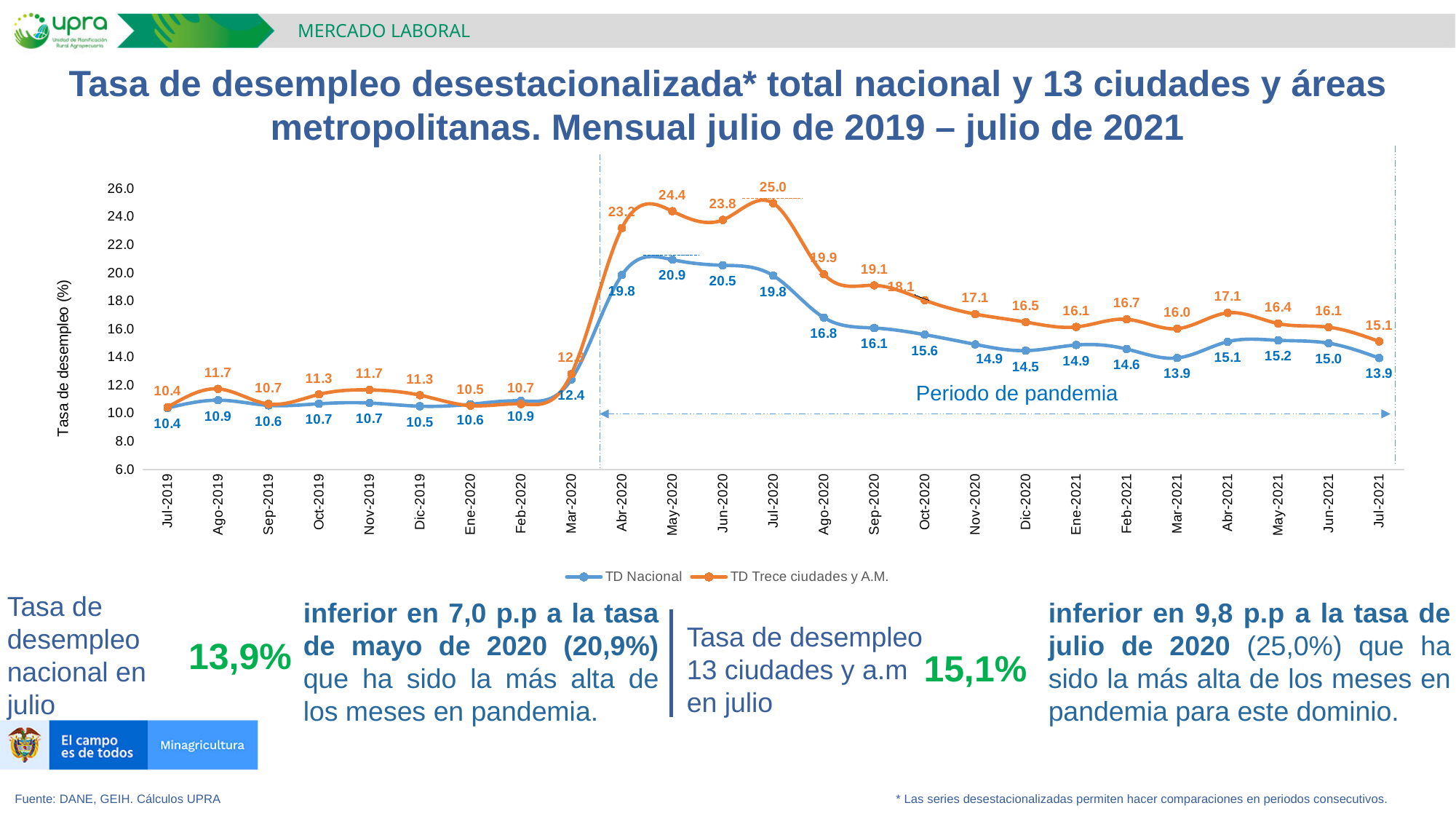
What is the TD Trece ciudades y A.M. value for Jul-2020? 25.0 What is the difference between the TD Nacional value in May-2020 and in Jul-2021? 7.0 What is the TD Nacional value for May-2020? 20.9 Does the TD Nacional series rise or fall from Jul-2020 to Dic-2020? Fall What type of chart is shown on the slide? Line chart In which month does the TD Trece ciudades y A.M. series reach its highest value? Jul-2020 Which series has the higher value in Ago-2020, TD Nacional or TD Trece ciudades y A.M.? TD Trece ciudades y A.M. How many series does the legend list? 2 In which month does the TD Nacional series reach its highest value? May-2020 How many months are plotted on the x axis? 25 What is the difference between the TD Trece ciudades y A.M. value and the TD Nacional value in Jul-2021? 1.2 What is the TD Nacional value for Jul-2021? 13.9